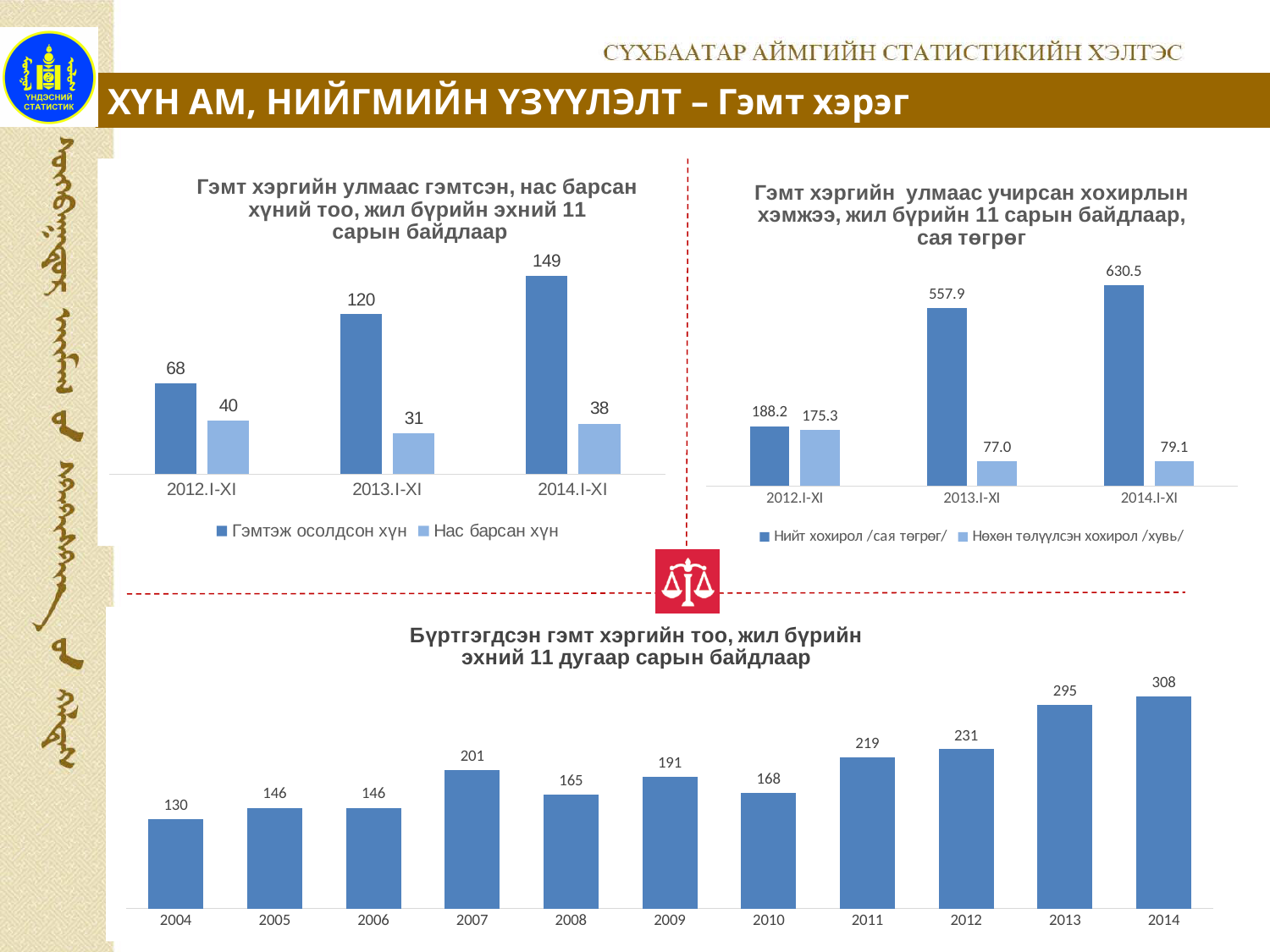
In the top-left chart (Гэмт хэргийн улмаас гэмтсэн, нас барсан хүний тоо), what is the value for Гэмтэж осолдсон хүн in 2014.I-XI? 149 In the bottom chart (Бүртгэгдсэн гэмт хэргийн тоо), which year has the lowest value? 2004 What kind of chart is the bottom chart (Бүртгэгдсэн гэмт хэргийн тоо)? Bar chart In the top-right chart (Гэмт хэргийн улмаас учирсан хохирлын хэмжээ), which year has the highest value for Нийт хохирол? 2014.I-XI In the top-left chart (Гэмт хэргийн улмаас гэмтсэн, нас барсан хүний тоо), what is the value for Нас барсан хүн in 2013.I-XI? 31 In the top-right chart (Гэмт хэргийн улмаас учирсан хохирлын хэмжээ), which is larger in 2012.I-XI: Нийт хохирол or Нөхөн төлүүлсэн хохирол? Нийт хохирол In the bottom chart (Бүртгэгдсэн гэмт хэргийн тоо), what is the value for 2007? 201 In the top-right chart (Гэмт хэргийн улмаас учирсан хохирлын хэмжээ), what is the value for Нийт хохирол in 2013.I-XI? 557.9 In the top-right chart (Гэмт хэргийн улмаас учирсан хохирлын хэмжээ), what is the value for Нөхөн төлүүлсэн хохирол in 2014.I-XI? 79.1 How many years are shown on the x axis of the bottom chart (Бүртгэгдсэн гэмт хэргийн тоо)? 11 In the top-left chart (Гэмт хэргийн улмаас гэмтсэн, нас барсан хүний тоо), what is the difference between Гэмтэж осолдсон хүн and Нас барсан хүн in 2012.I-XI? 28 How many series does the legend of the top-left chart (Гэмт хэргийн улмаас гэмтсэн, нас барсан хүний тоо) list? 2